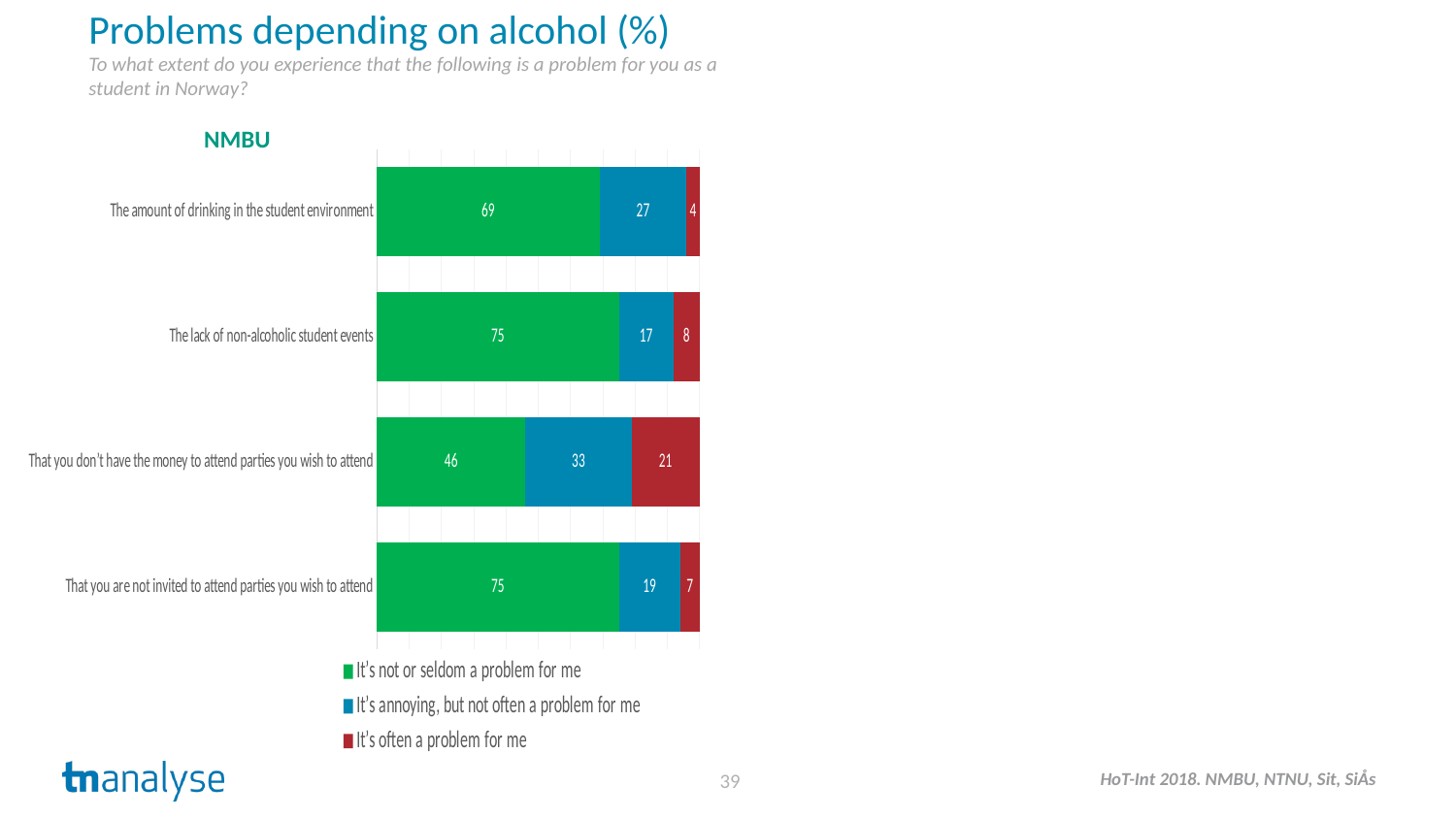
Which colour represents 'It's often a problem for me' in the chart? Red What percentage of NMBU students say the amount of drinking in the student environment is not or seldom a problem for them? 69 What is the difference between the 'It's not or seldom a problem for me' values for 'The lack of non-alcoholic student events' and 'The amount of drinking in the student environment'? 6 What is the value for 'It's often a problem for me' for 'That you don't have the money to attend parties you wish to attend'? 21 What kind of chart is shown on the slide? Stacked bar chart Which category has the highest value for 'It's often a problem for me'? That you don't have the money to attend parties you wish to attend Which is larger: the 'It's annoying, but not often a problem for me' value for 'The amount of drinking in the student environment' or for 'That you are not invited to attend parties you wish to attend'? The amount of drinking in the student environment How many series does the legend list? 3 Which category has the lowest value for 'It's not or seldom a problem for me'? That you don't have the money to attend parties you wish to attend What is the total of the stacked bar for 'That you don't have the money to attend parties you wish to attend'? 100 How many categories are shown in the chart? 4 What is the value for 'It's annoying, but not often a problem for me' for 'The lack of non-alcoholic student events'? 17